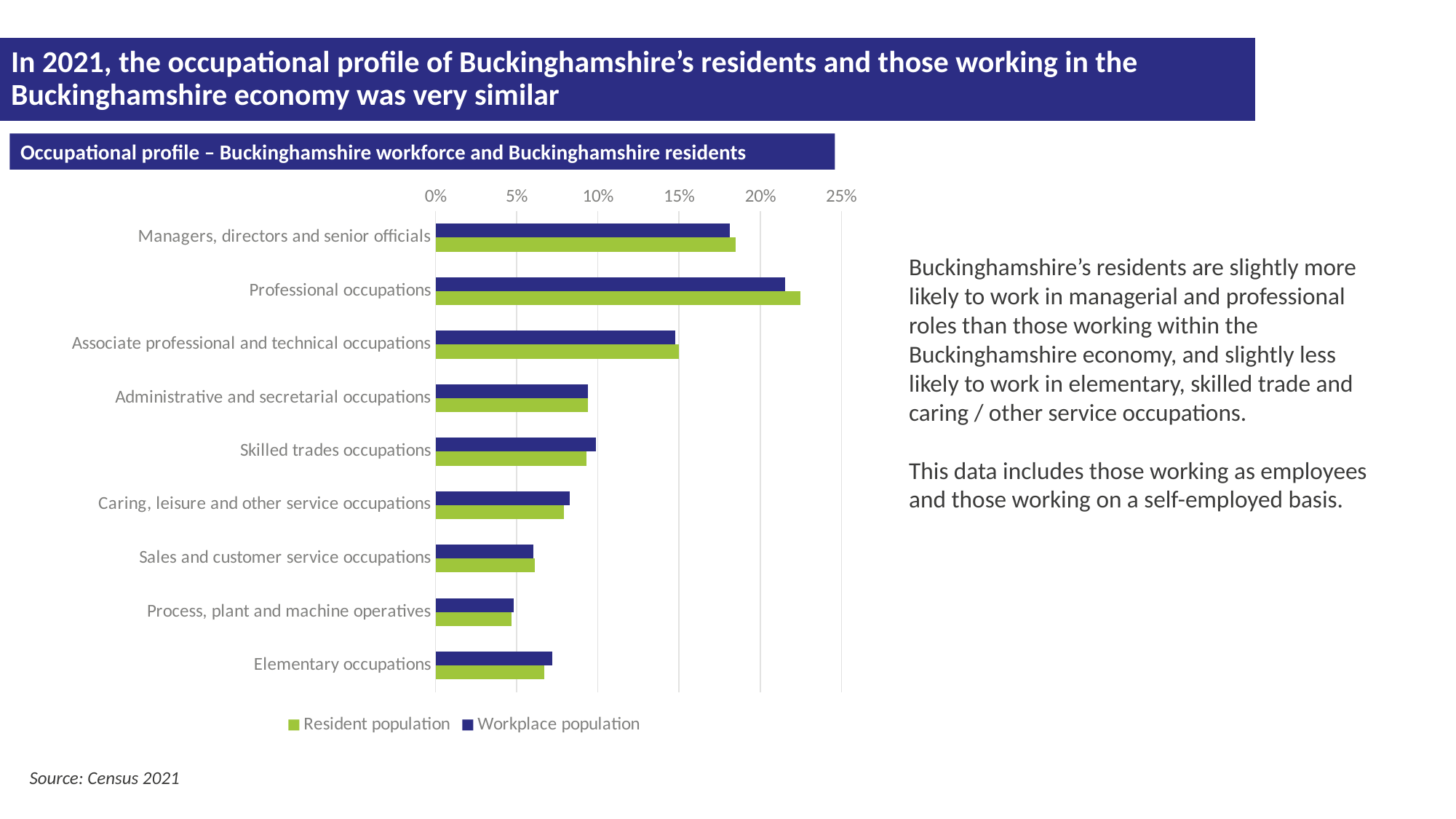
Which occupation category has the highest value for the Resident population? Professional occupations How many occupation categories are plotted on the chart? 9 Is the Resident population value for Associate professional and technical occupations greater or less than 10%? greater Which occupation category has the lowest value for the Workplace population? Process, plant and machine operatives Which colour represents the Resident population in the chart? Green Is the Resident population value for Professional occupations greater or less than 20%? greater What kind of chart is shown on the slide? Bar chart How many series does the chart's legend list? 2 For Professional occupations, which is larger: the Resident population value or the Workplace population value? Resident population Is the Workplace population value for Managers, directors and senior officials greater or less than 15%? greater For Elementary occupations, which is larger: the Resident population value or the Workplace population value? Workplace population